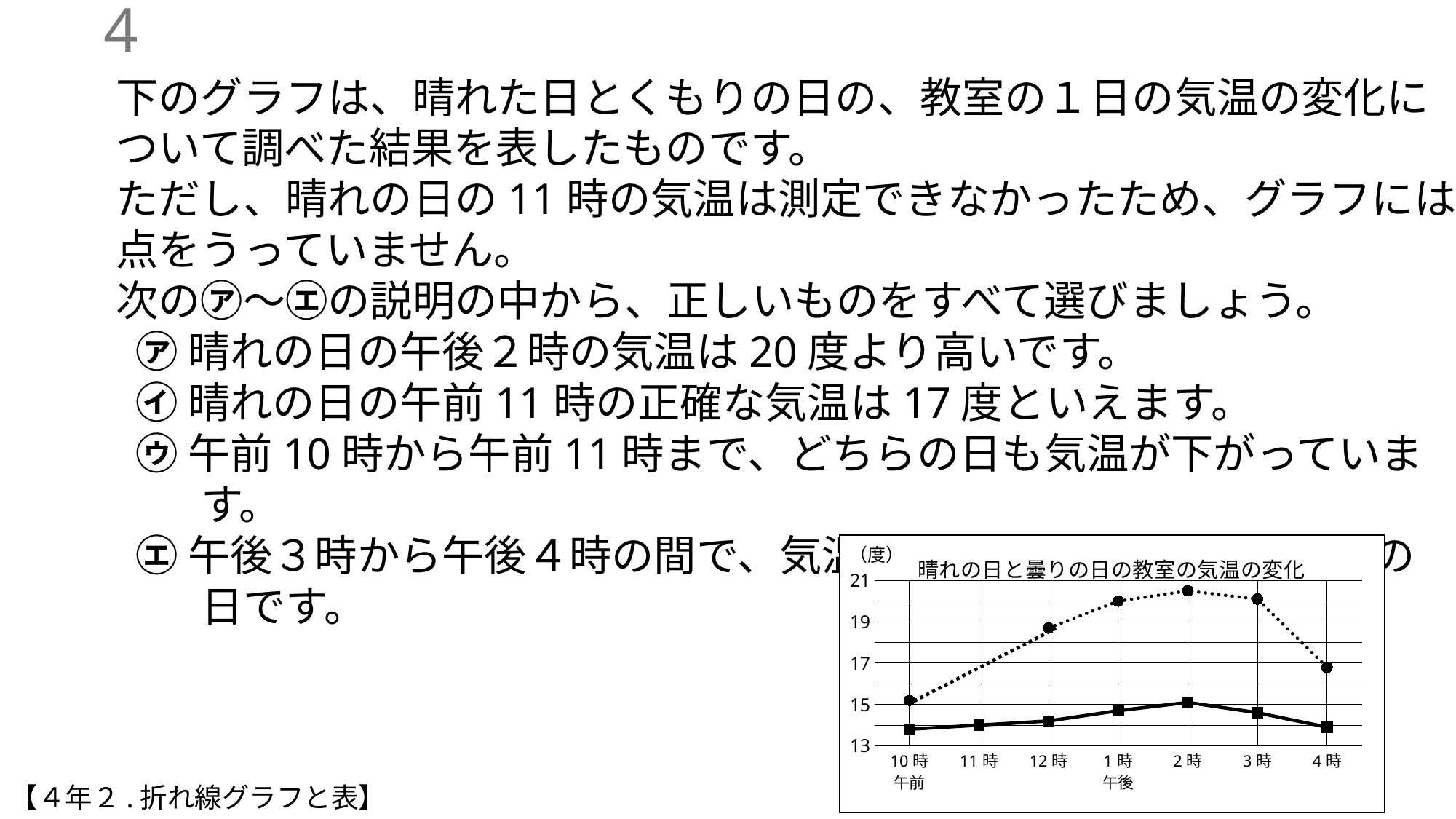
点線（晴れの日）の気温が最も低いのは何時ですか。 午前10時 午後4時の気温は、点線（晴れの日）と実線（曇りの日）のどちらが高いですか。 点線（晴れの日） 実線（曇りの日）の午前10時の気温は15度より高いですか、低いですか。 低い 横軸には時刻がいくつ示されていますか。 7 実線（曇りの日）の気温は午前10時から午後2時にかけて上がっていますか、下がっていますか。 上がっている 点線（晴れの日）の気温は午後3時から午後4時にかけて上がっていますか、下がっていますか。 下がっている 点線（晴れの日）の気温が最も高いのは何時ですか。 午後2時 グラフには折れ線が何本ありますか。 2 点線（晴れの日）の午後1時の気温は19度より高いですか、低いですか。 高い グラフのタイトルは何ですか。 晴れの日と曇りの日の教室の気温の変化 このグラフはどんな種類のグラフですか。 折れ線グラフ 実線（曇りの日）の気温が最も高いのは何時ですか。 午後2時